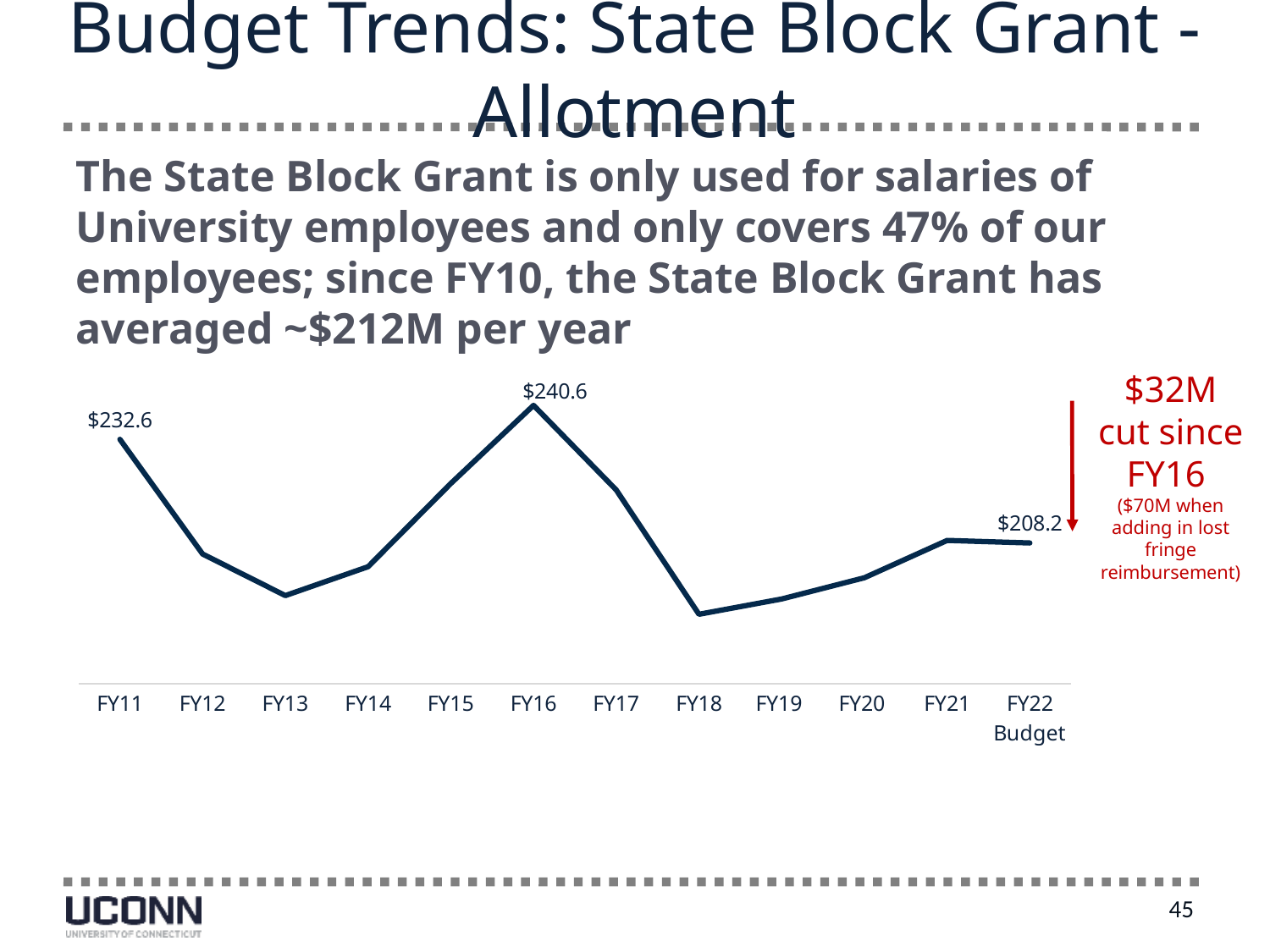
What type of chart is shown on the slide? Line chart Which is larger, the value for FY11 or the value for FY16? FY16 What is the difference between the FY16 value and the FY22 Budget value? $32.4 What does the red annotation to the right of the chart say has happened since FY16? $32M cut since FY16 What is the State Block Grant value for FY11? $232.6 Do the values rise or fall from FY16 to FY18? Fall How many fiscal years are plotted on the x axis? 12 What is the State Block Grant value for FY16? $240.6 What is the value for FY22 Budget? $208.2 What is the difference between the FY11 value and the FY22 Budget value? $24.4 Which fiscal year has the highest value on the chart? FY16 Which fiscal year has the lowest value on the chart? FY18